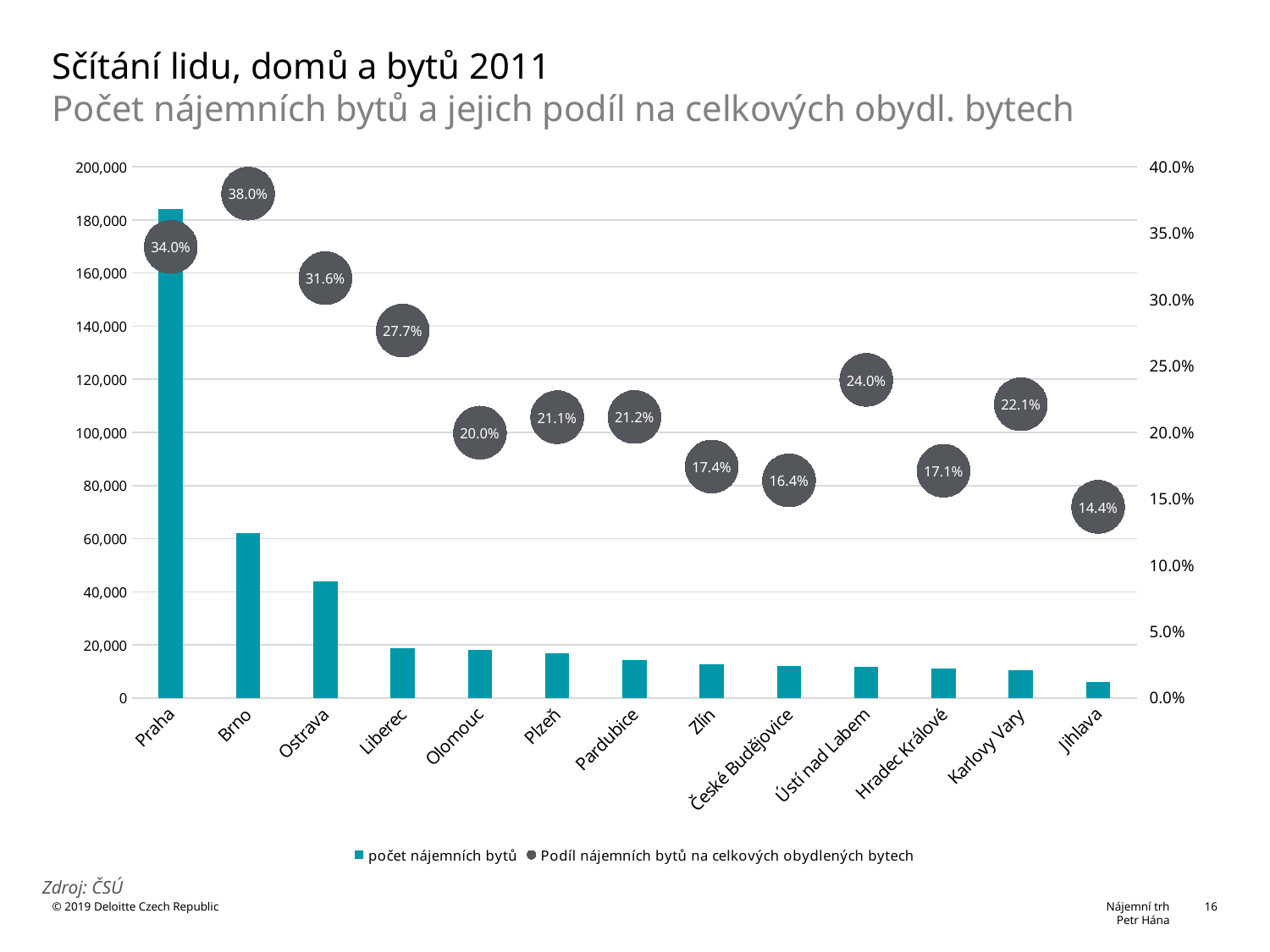
Is the number of rental flats (počet nájemních bytů) for Praha greater or less than 160,000? greater How many cities are shown on the x axis of the chart? 13 Which city has the highest share of rental flats on total occupied flats? Brno What is the share of rental flats shown for Ústí nad Labem? 24.0% Which city has the tallest bar for the number of rental flats? Praha Which city has the larger share of rental flats, Pardubice or Plzeň? Pardubice By how many percentage points does Brno's share of rental flats exceed Praha's? 4.0 percentage points What is the share of rental flats shown for Jihlava? 14.4% How many series does the chart legend list? 2 Is the number of rental flats for Ostrava greater or less than 60,000? less Which city has the lowest share of rental flats on total occupied flats? Jihlava What is the share of rental flats (Podíl nájemních bytů) shown for Brno? 38.0%